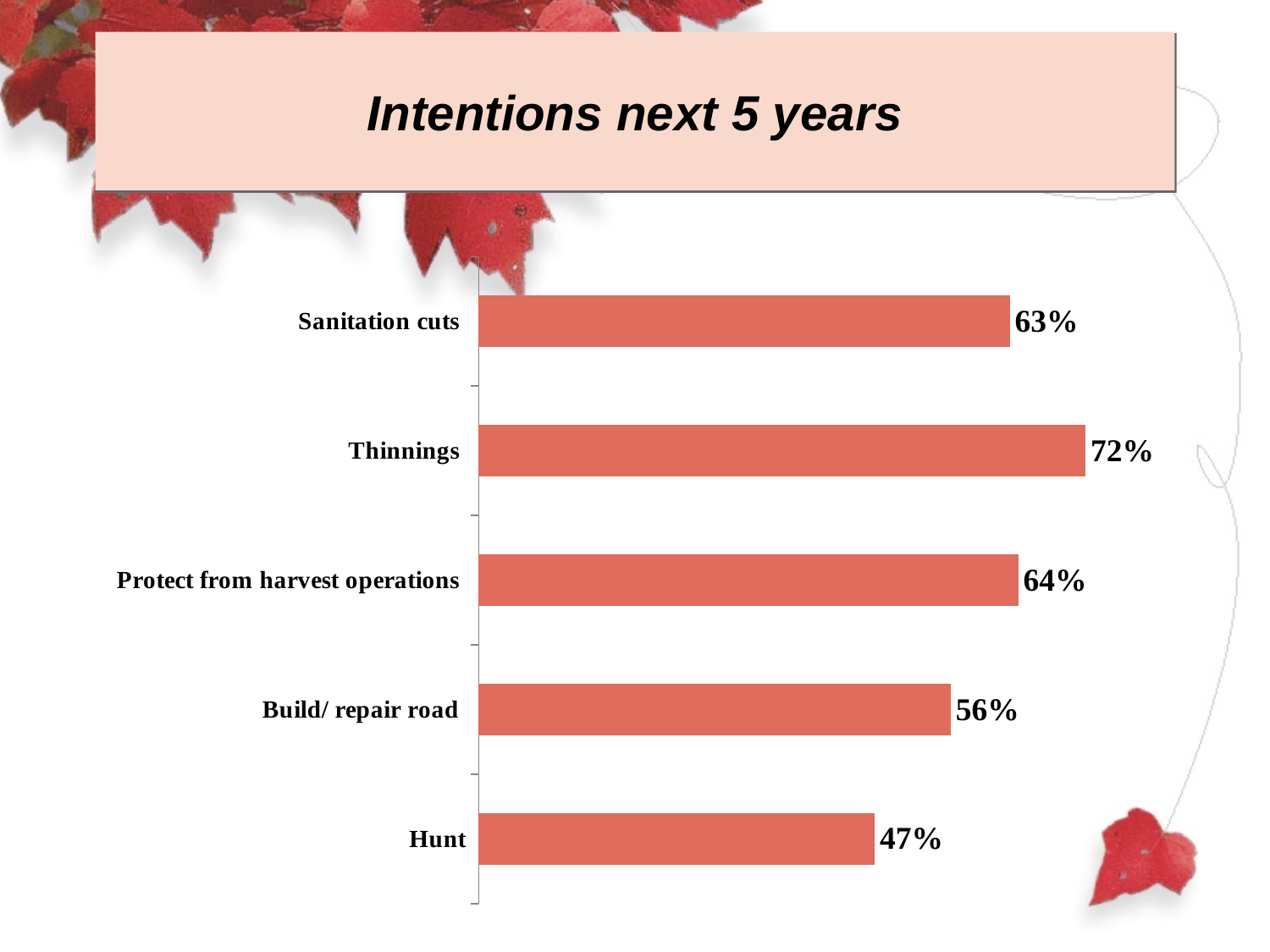
Which category has the highest value? Thinnings What is the value for Protect from harvest operations? 64% What is the value for Build/ repair road? 56% What is the difference between the values for Thinnings and Hunt? 25% Which category has the lowest value? Hunt What is the value for Thinnings? 72% What is the difference between the values for Protect from harvest operations and Sanitation cuts? 1% How many categories are shown in the chart? 5 What kind of chart is shown on the slide? Bar chart What is the value for Hunt? 47% What is the title of the slide containing the chart? Intentions next 5 years Which is larger, the value for Sanitation cuts or the value for Build/ repair road? Sanitation cuts